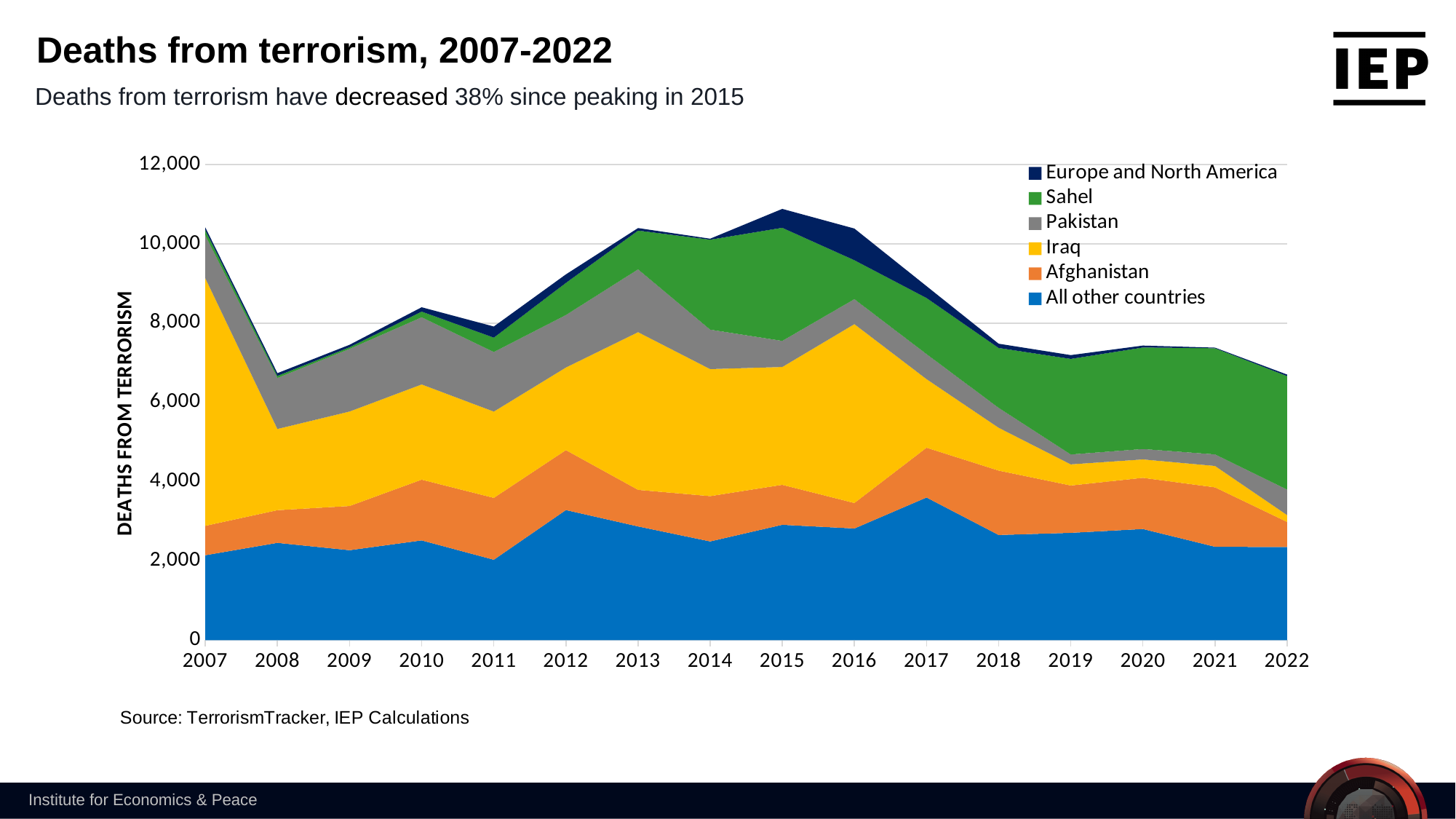
Is the total number of deaths from terrorism in 2022 greater or less than 8,000? less What is the title of the chart? Deaths from terrorism, 2007-2022 Do total deaths from terrorism rise or fall between 2015 and 2022? fall Is the total number of deaths from terrorism in 2015 greater or less than 10,000? greater Is the total number of deaths from terrorism in 2007 greater or less than 10,000? greater What kind of chart is shown on the slide? Stacked area chart Which series is plotted at the bottom of the stacked area chart? All other countries Do total deaths from terrorism rise or fall between 2008 and 2013? rise How many series does the legend list? 6 In which year did total deaths from terrorism peak? 2015 How many years are plotted along the x axis? 16